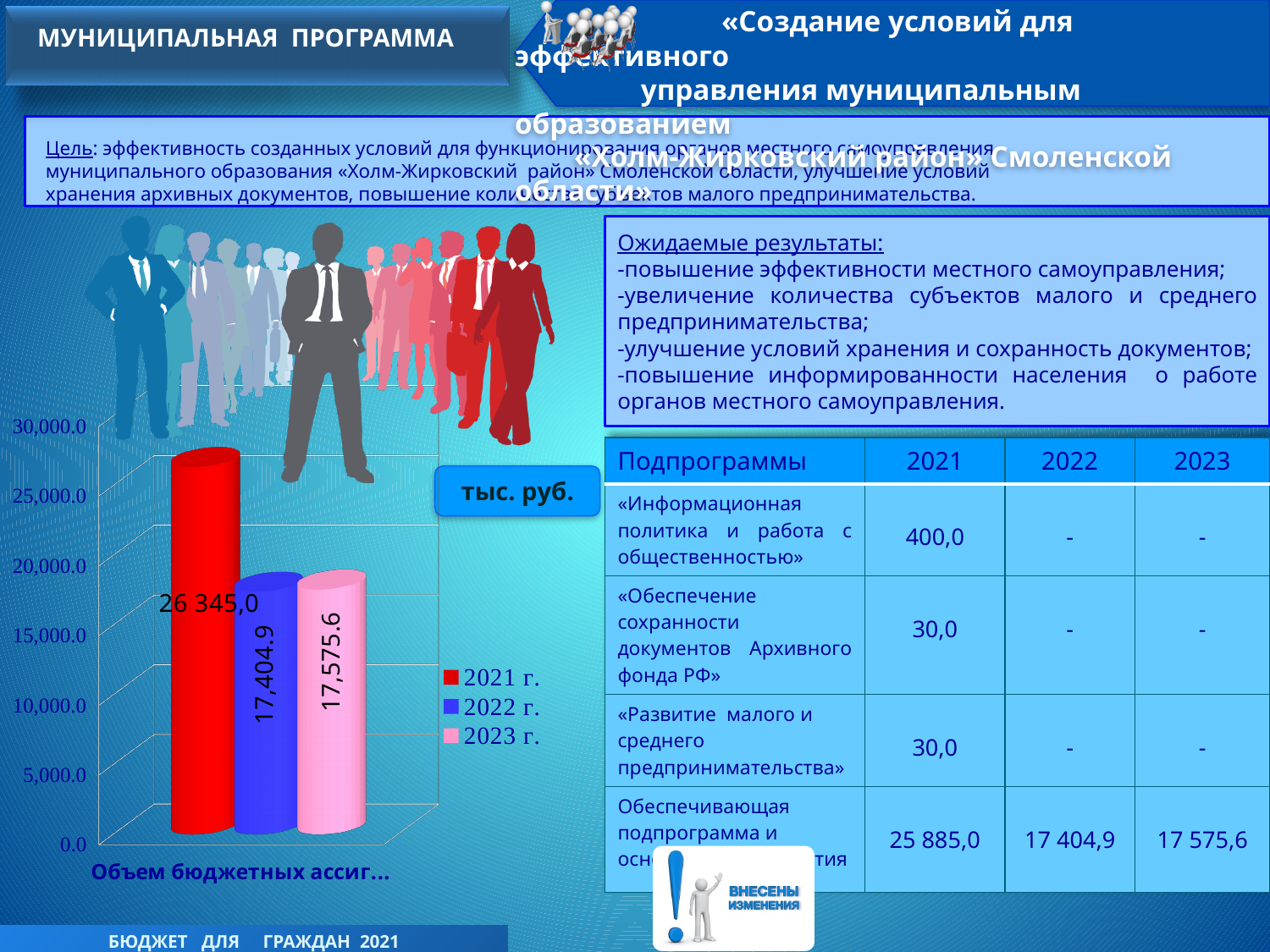
What is the value shown for 2021 г. in the bar chart? 26 345,0 Which is larger in the bar chart, the value for 2021 г. or for 2022 г.? 2021 г. What is the value shown for 2022 г. in the bar chart? 17,404.9 What kind of chart is shown on the slide? bar chart How many series does the legend of the bar chart list? 3 What is the value shown for 2023 г. in the bar chart? 17,575.6 What is the difference between the values for 2023 г. and 2022 г. in the bar chart? 170.7 Is the value for 2021 г. in the bar chart greater or less than 25,000.0? greater Is the value for 2022 г. in the bar chart greater or less than 20,000.0? less Which year has the lowest value in the bar chart? 2022 г. Which year has the highest bar in the chart? 2021 г. What colour is the bar for 2021 г. in the chart? red